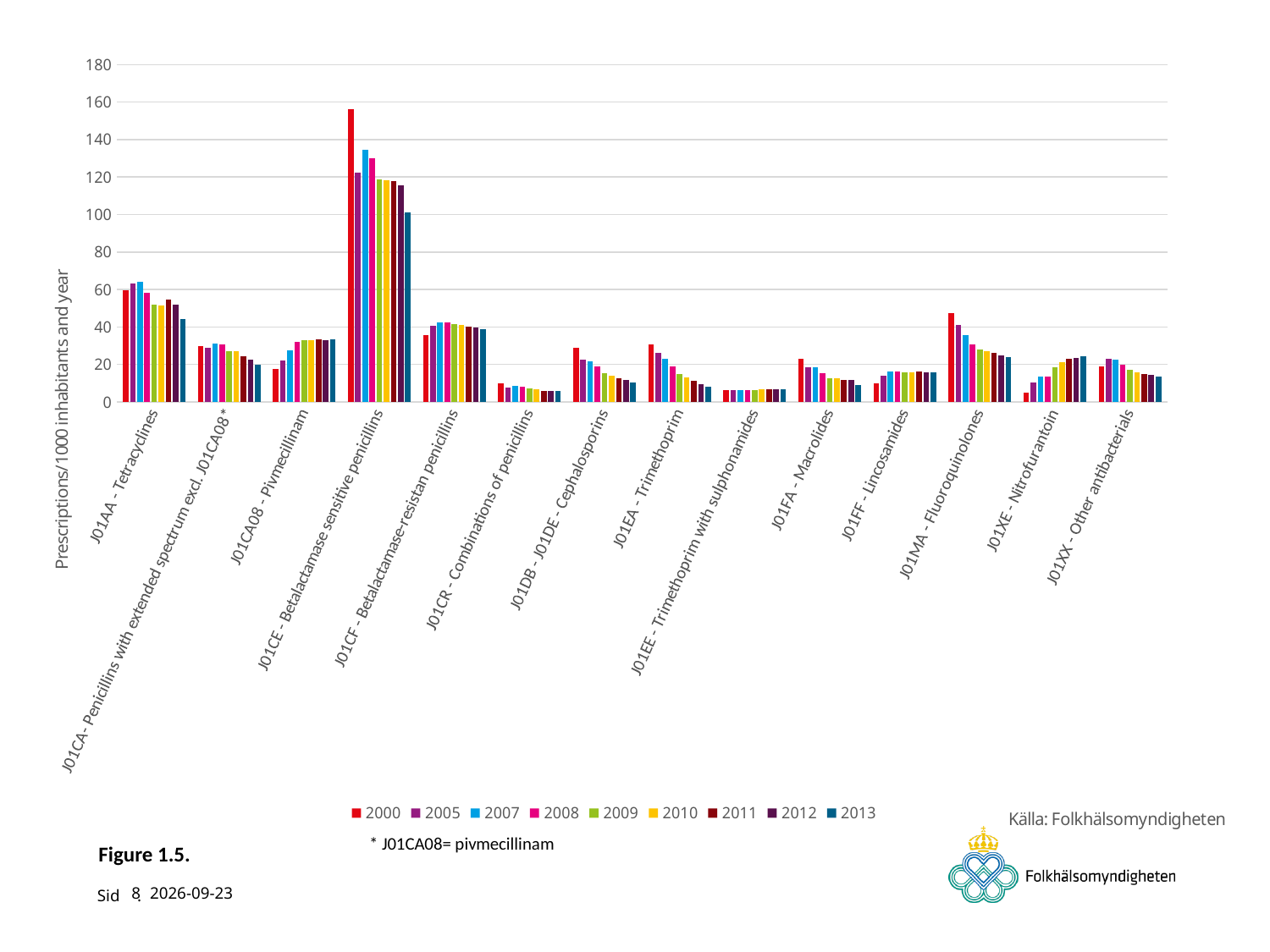
Is the value for J01AA - Tetracyclines in 2007 greater or less than 60? greater Is the value for J01CE - Betalactamase sensitive penicillins in 2000 greater or less than 140? greater Which is larger for J01EA - Trimethoprim: the value for 2000 or the value for 2013? 2000 Do the values for J01XE - Nitrofurantoin rise or fall from 2000 to 2013? rise How many antibiotic categories are shown along the x axis? 14 Is the value for J01MA - Fluoroquinolones in 2000 greater or less than 40? greater What kind of chart is shown on the slide? bar chart Which category has the highest value for 2000? J01CE - Betalactamase sensitive penicillins How many series does the legend list? 9 Do the values for J01CE - Betalactamase sensitive penicillins rise or fall from 2000 to 2013? fall What is the label on the vertical axis? Prescriptions/1000 inhabitants and year